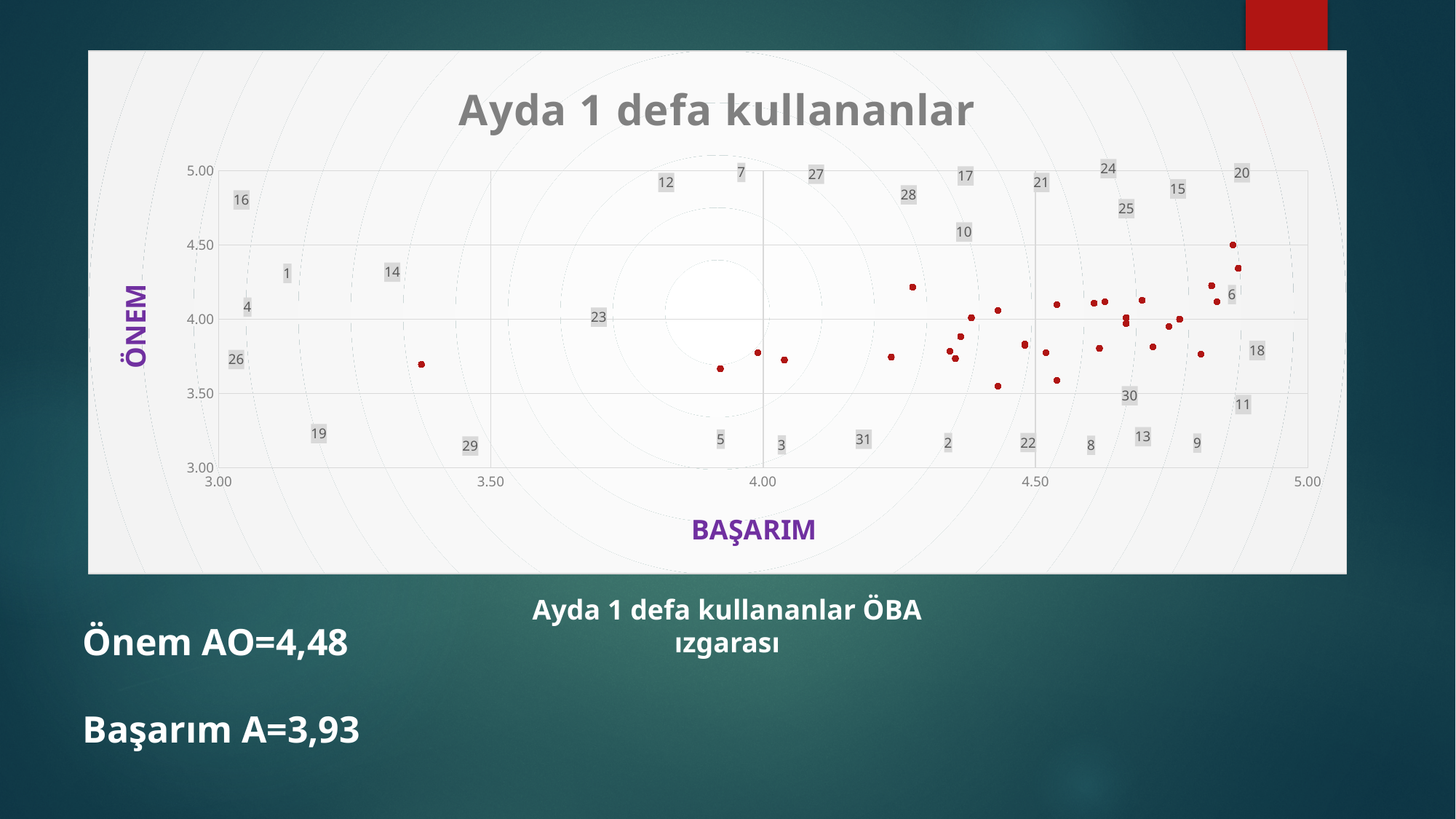
What is the title of the chart? Ayda 1 defa kullananlar Is the ÖNEM value of the leftmost point in the chart greater or less than 4.00? less What is the label of the vertical axis of the chart? ÖNEM Is the BAŞARIM value of the leftmost point in the chart greater or less than 3.50? less Is the ÖNEM value of the lowest point in the chart greater or less than 4.00? less Which has the higher ÖNEM value: the leftmost point or the rightmost point in the chart? the rightmost point What kind of chart is shown on the slide? scatter chart